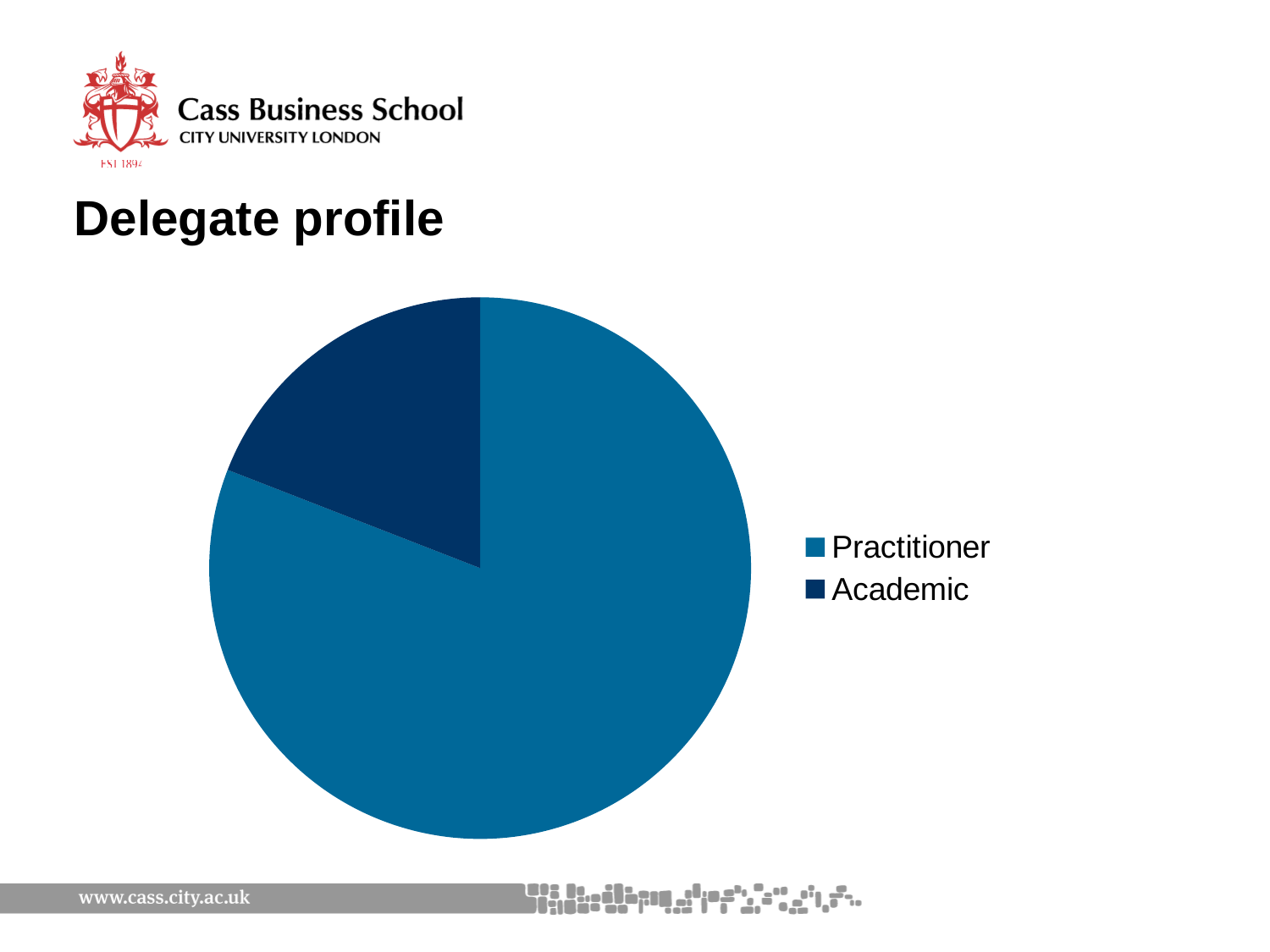
What is the title of the slide containing the pie chart? Delegate profile Which slice is larger, Practitioner or Academic? Practitioner How many entries does the legend of the pie chart list? 2 Which category has the smallest slice of the pie chart? Academic How many slices does the pie chart have? 2 What kind of chart is shown on the slide? pie chart Which category has the largest slice of the pie chart? Practitioner Which legend entry is shown in the darker blue colour? Academic